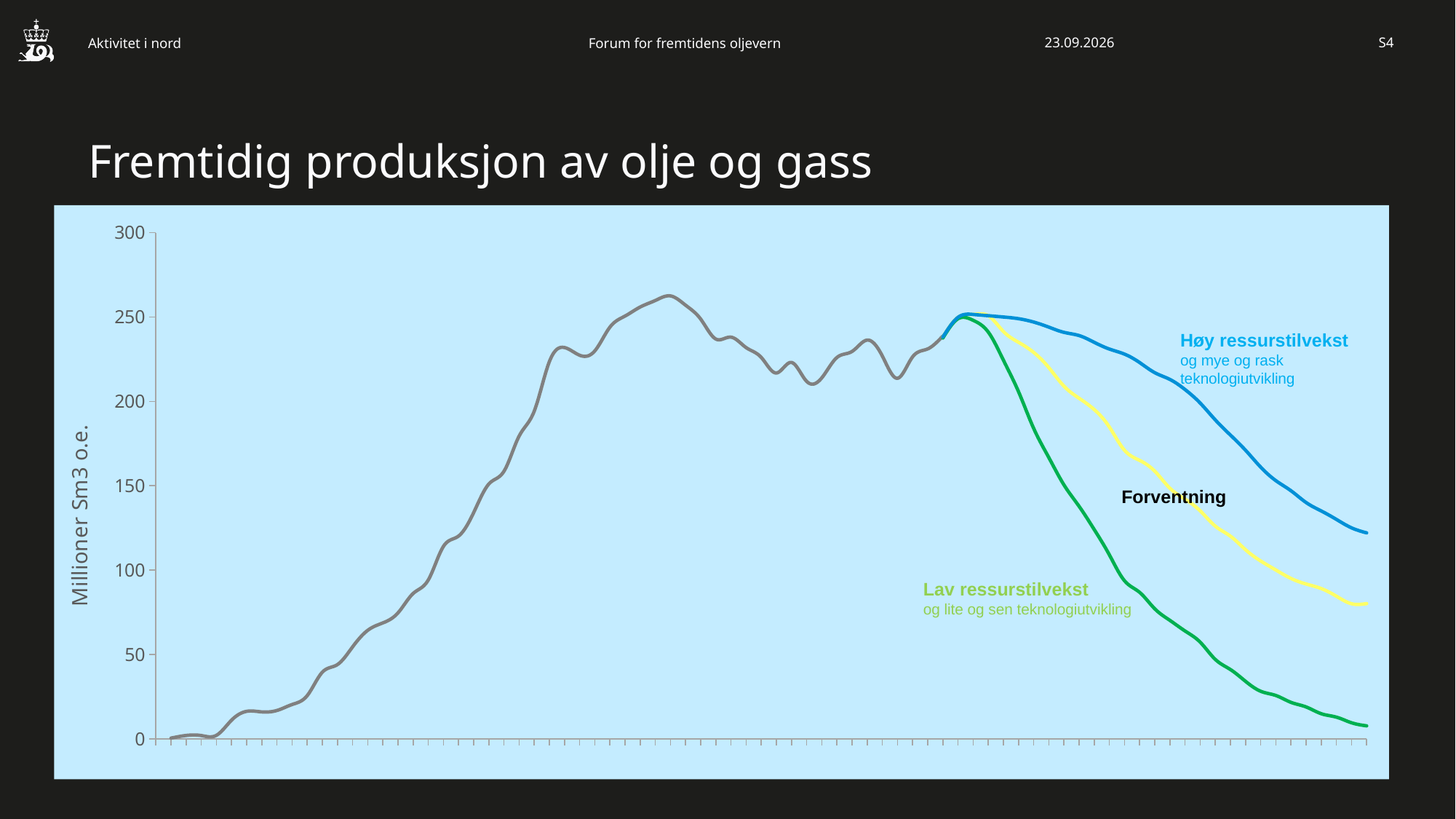
Is the final value of the Lav ressurstilvekst line greater or less than 50? less Is the final value of the Høy ressurstilvekst line greater or less than 100? greater Is the final value of the Forventning line greater or less than 100? less At the right edge of the chart, which line is higher: Forventning or Lav ressurstilvekst? Forventning What colour is the Forventning line? yellow Which scenario line ends at the highest value at the right edge of the chart? Høy ressurstilvekst Which scenario line ends at the lowest value at the right edge of the chart? Lav ressurstilvekst How many future scenario lines are labelled on the chart? 3 What kind of chart is shown on the slide? line chart Do the three scenario lines rise or fall from left to right after they split from the historical line? fall What is the label on the vertical axis of the chart? Millioner Sm3 o.e.